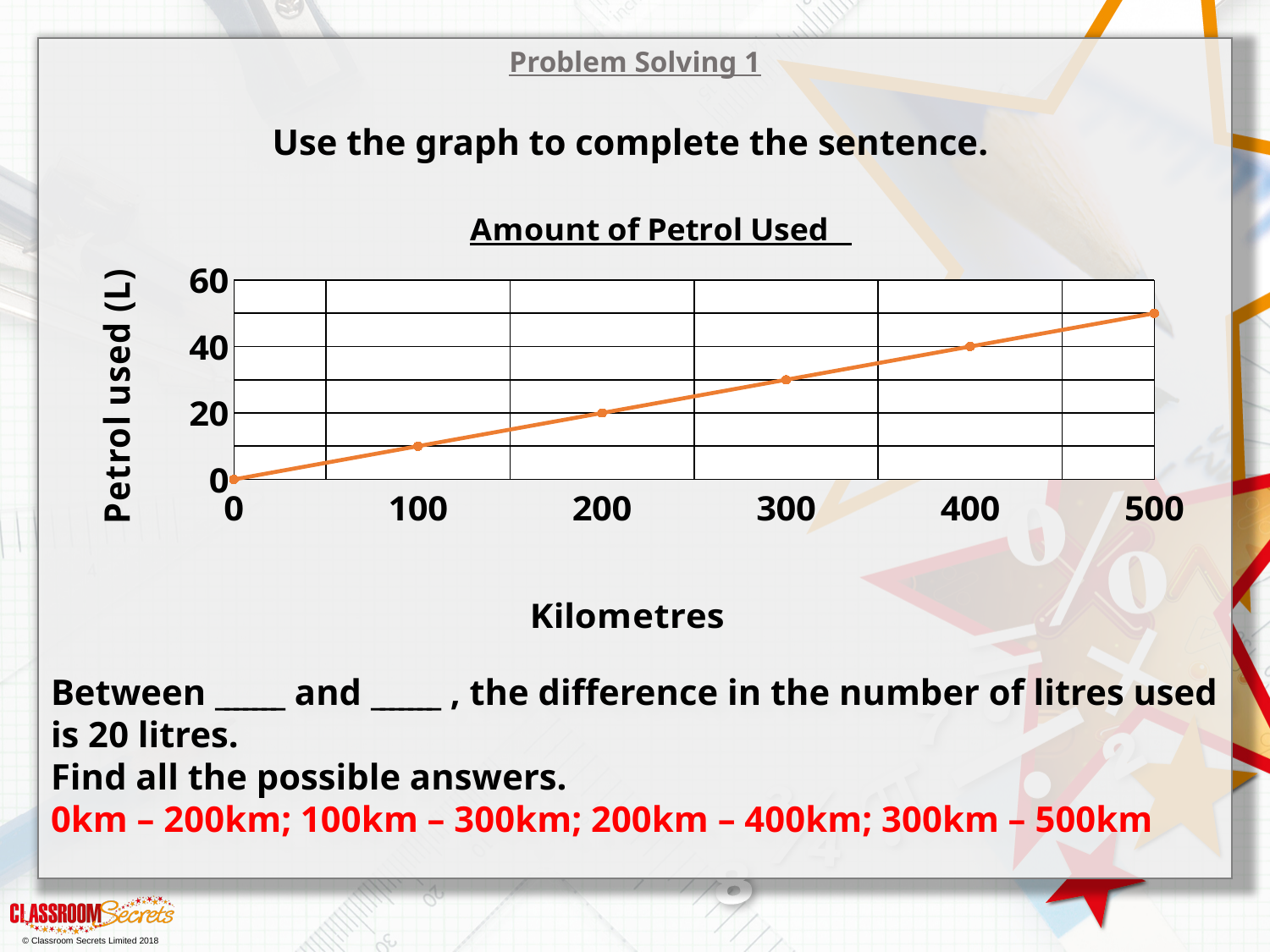
What type of chart is shown on the slide? line chart What is the title of the chart? Amount of Petrol Used What is the difference in petrol used between 400 kilometres and 200 kilometres? 20 Does the petrol used rise or fall as the kilometres increase? rise How much petrol is used at 0 kilometres? 0 At which number of kilometres is the petrol used highest? 500 Is the petrol used at 500 kilometres greater or less than 40? greater What is the label of the vertical axis? Petrol used (L) Is the petrol used at 300 kilometres greater or less than 40? less How much petrol is used at 200 kilometres? 20 How much petrol is used at 400 kilometres? 40 How many data points are plotted on the line? 6